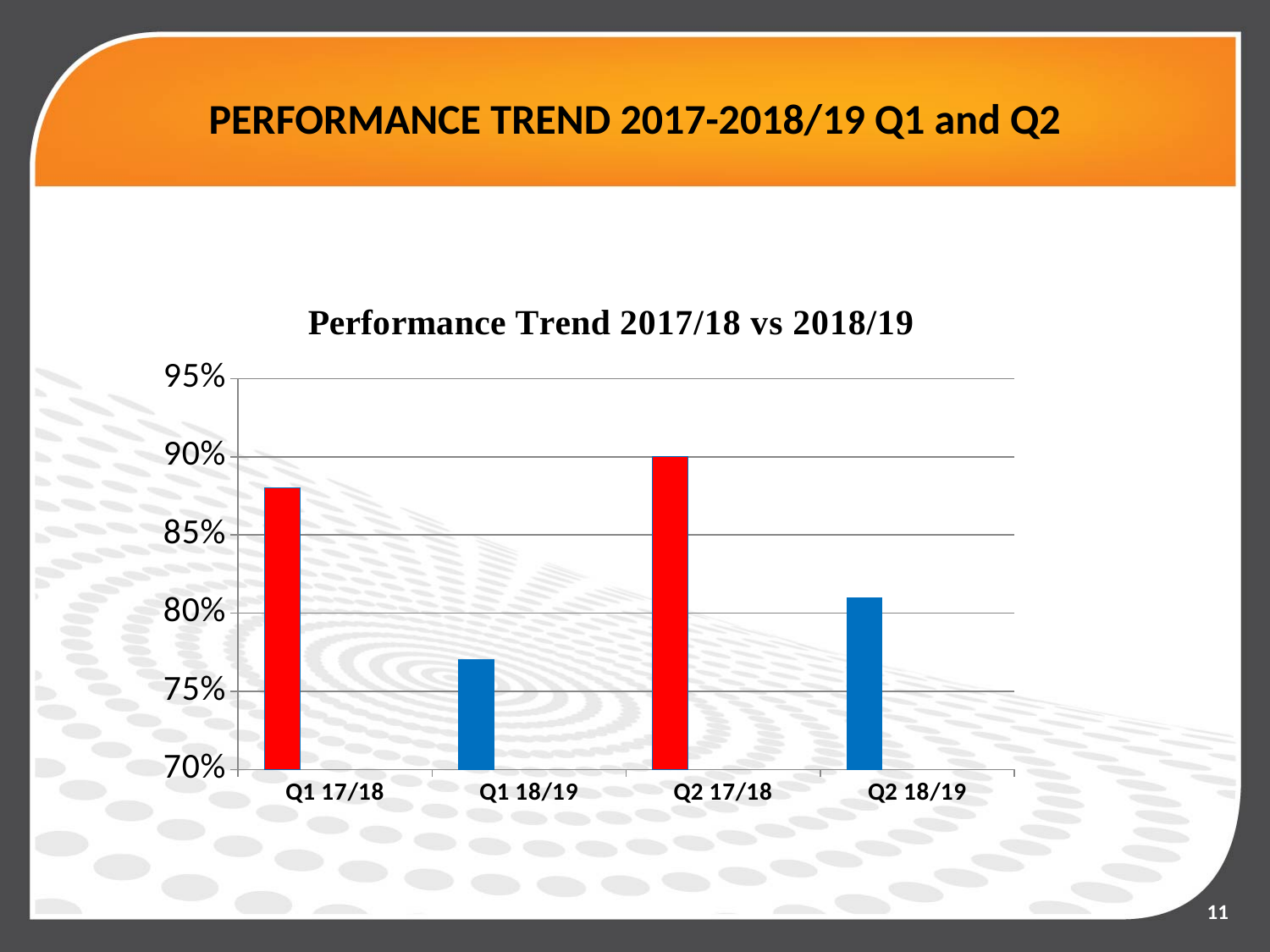
Which is larger, the value for Q1 17/18 or the value for Q1 18/19? Q1 17/18 Which category has the lowest value? Q1 18/19 What kind of chart is shown on the slide? bar chart Is the value for Q1 17/18 greater or less than 85%? greater What colour are the bars for the 17/18 quarters? red What is the title of the chart? Performance Trend 2017/18 vs 2018/19 Is the value for Q1 18/19 greater or less than 80%? less Is the value for Q2 18/19 greater or less than 85%? less How many bars are plotted in the chart? 4 Which is larger, the value for Q2 17/18 or the value for Q2 18/19? Q2 17/18 Which category has the highest value? Q2 17/18